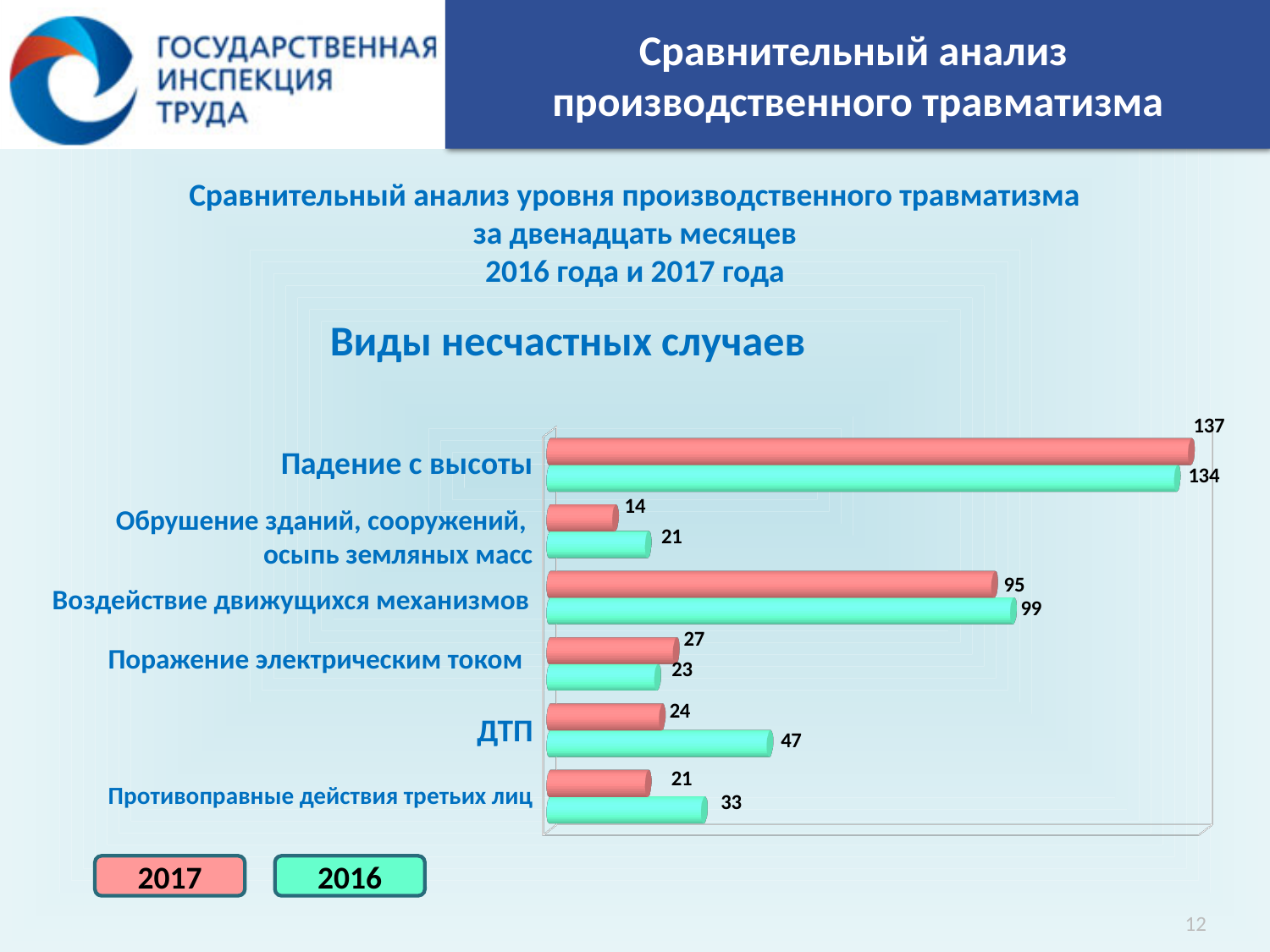
What is the difference between the 2016 and 2017 values for ДТП? 23 What kind of chart is shown on the slide? Bar chart How many series does the legend list? 2 Which category has the lowest 2017 value? Обрушение зданий, сооружений, осыпь земляных масс What is the 2016 value for Противоправные действия третьих лиц? 33 How many categories are shown in the chart? 6 What is the 2017 value for Падение с высоты? 137 What is the 2016 value for ДТП? 47 Which colour represents 2017 in the chart? Red (pink) Which category has the highest 2016 value? Падение с высоты What is the 2017 value for Обрушение зданий, сооружений, осыпь земляных масс? 14 For Воздействие движущихся механизмов, which year has the larger value, 2016 or 2017? 2016